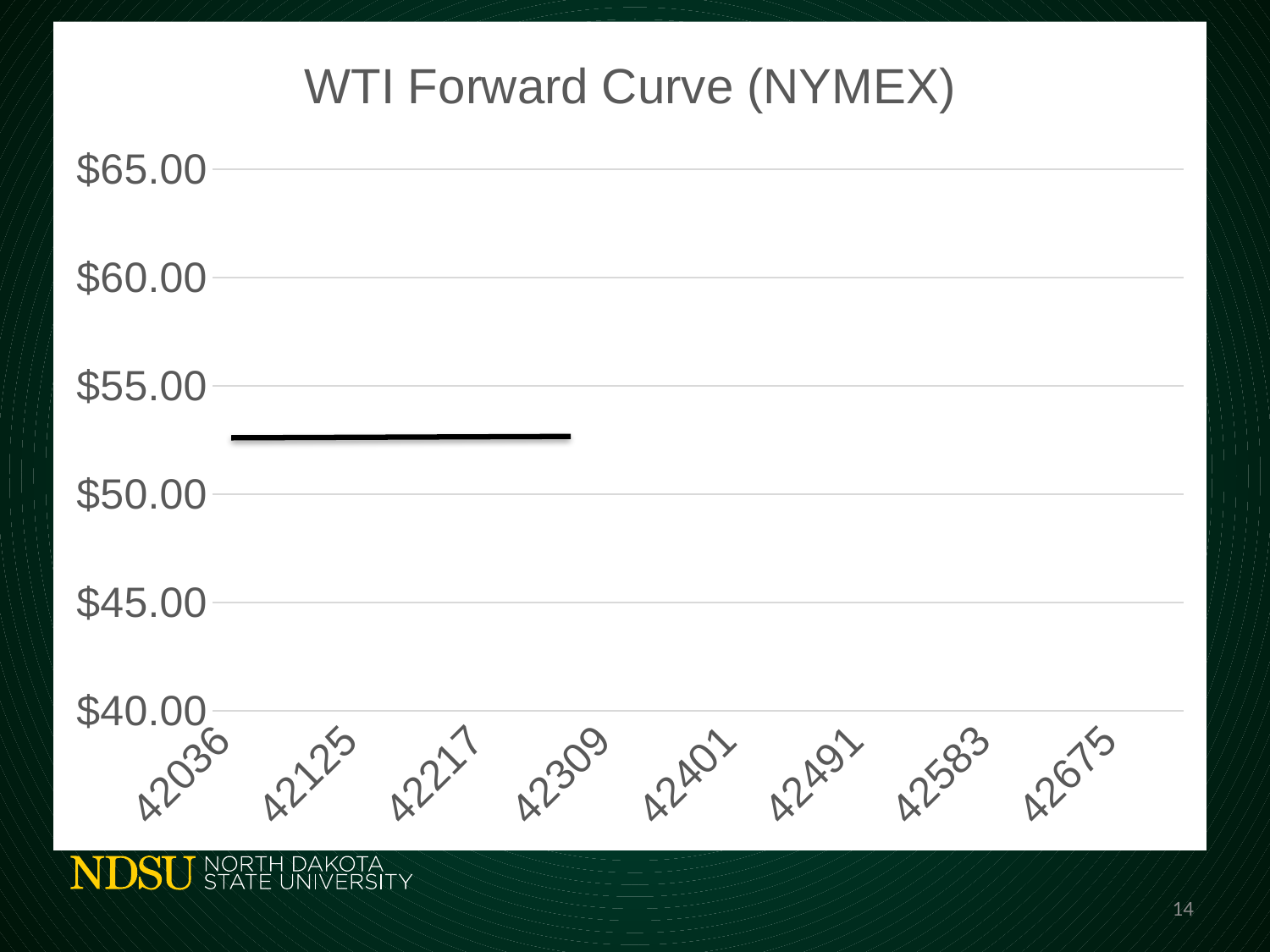
What kind of chart is shown on the slide? line chart What is the title of the chart? WTI Forward Curve (NYMEX) What is the lowest value shown on the y axis? $40.00 Is the value plotted at 42217 greater or less than $60.00? less Is the value plotted at 42309 greater or less than $45.00? greater Is the value plotted at 42036 greater or less than $50.00? greater What is the last category label on the x axis? 42675 What is the first category label on the x axis? 42036 How many category labels are shown on the x axis? 8 Does the plotted line rise, fall, or stay roughly flat from 42036 to 42309? roughly flat